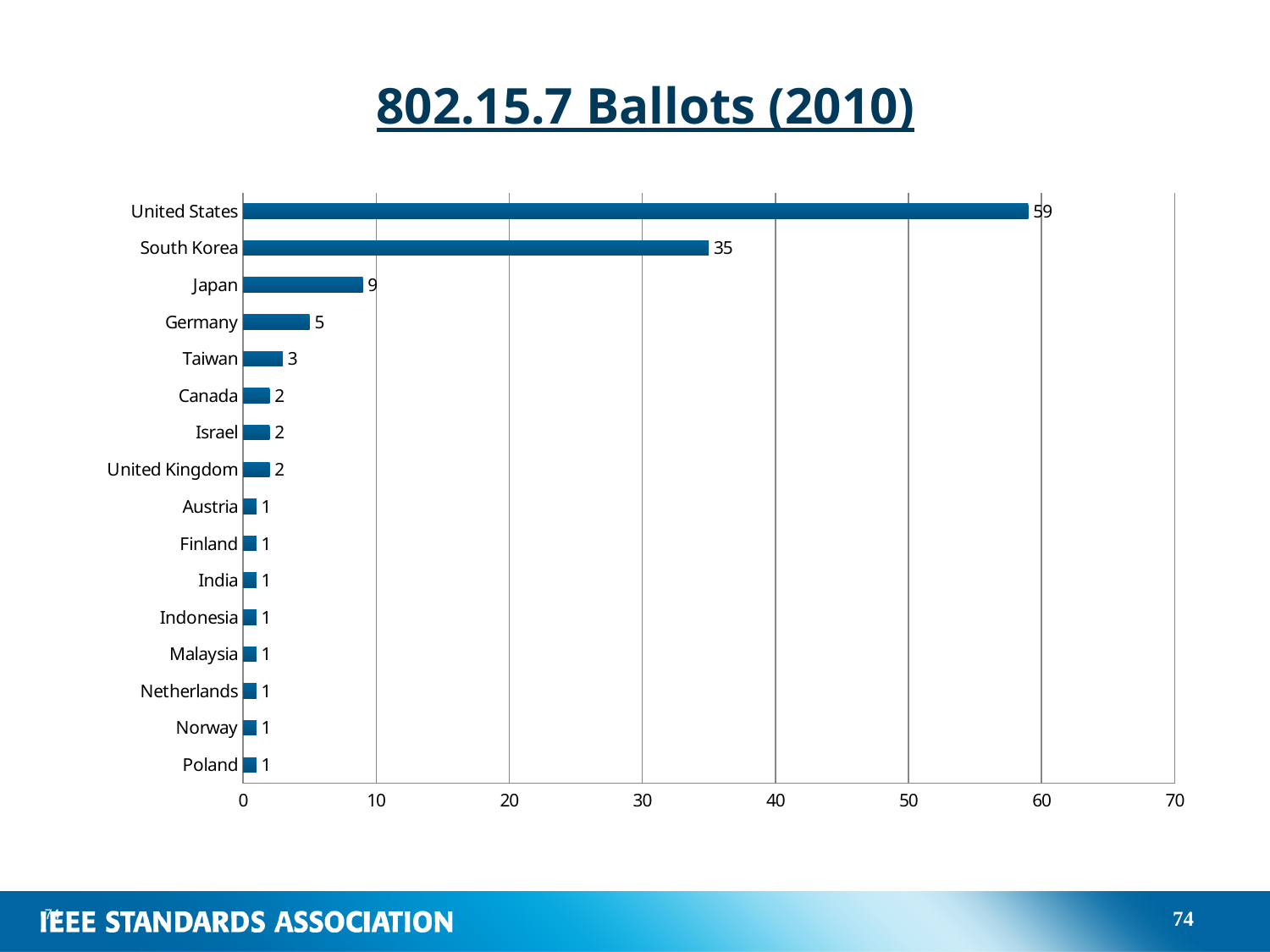
How many countries have a value of 1? 8 What is the value for United States? 59 Which is larger, the value for Taiwan or the value for Germany? Germany What is the title of the chart? 802.15.7 Ballots (2010) How many countries are shown in the chart? 16 What is the value for Germany? 5 What kind of chart is shown on the slide? bar chart Which country has the highest number of ballots? United States What is the value for Japan? 9 What is the difference between the values for United States and South Korea? 24 What is the value for South Korea? 35 Is the value for South Korea greater or less than 30? greater